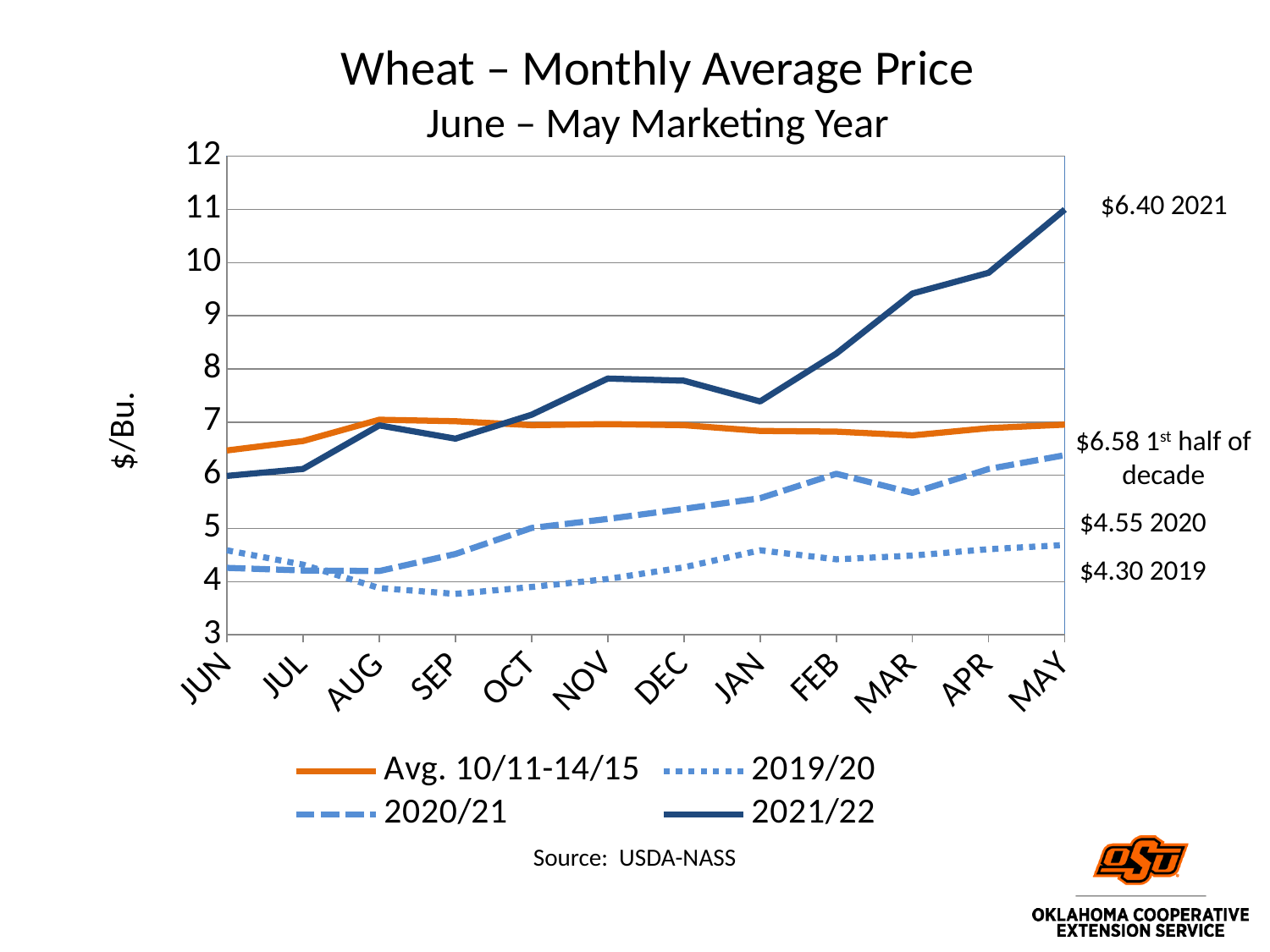
Is the 2021/22 value for MAY greater or less than 10? greater Does the 2021/22 line rise or fall from JAN to MAY? rise How many series does the legend list? 4 What is the label on the y axis? $/Bu. In MAY, which is larger: the 2021/22 value or the 2019/20 value? 2021/22 How many months are shown along the x axis? 12 Is the 2020/21 value for FEB greater or less than 5? greater Is the 2019/20 value for SEP greater or less than 4? less Which series has the highest value in MAY? 2021/22 What kind of chart is shown on the slide? line chart Which series has the lowest value in SEP? 2019/20